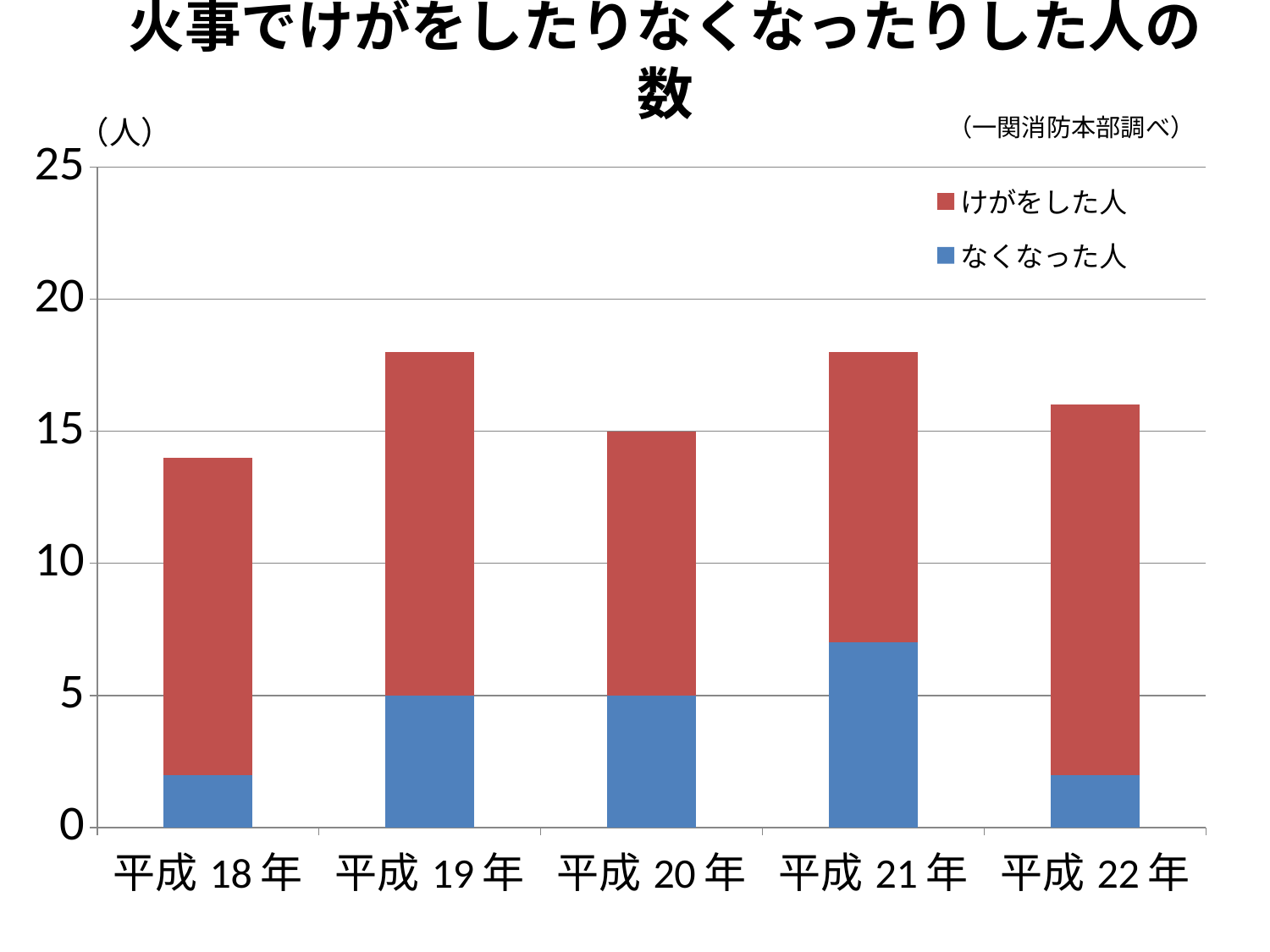
What kind of chart is shown on the slide? stacked bar chart Which year has the highest value for なくなった人? 平成21年 What is the value of なくなった人 for 平成19年? 5 How many series does the legend list? 2 Which colour represents けがをした人 in the legend? red Which year has the lowest total stacked bar? 平成18年 What is the value of なくなった人 for 平成20年? 5 How many years (categories) are shown on the x axis? 5 Is the value of なくなった人 for 平成21年 greater or less than 5? greater Is the total for 平成22年 greater or less than 15? greater Is the total for 平成18年 greater or less than 15? less What is the total height of the stacked bar for 平成20年? 15